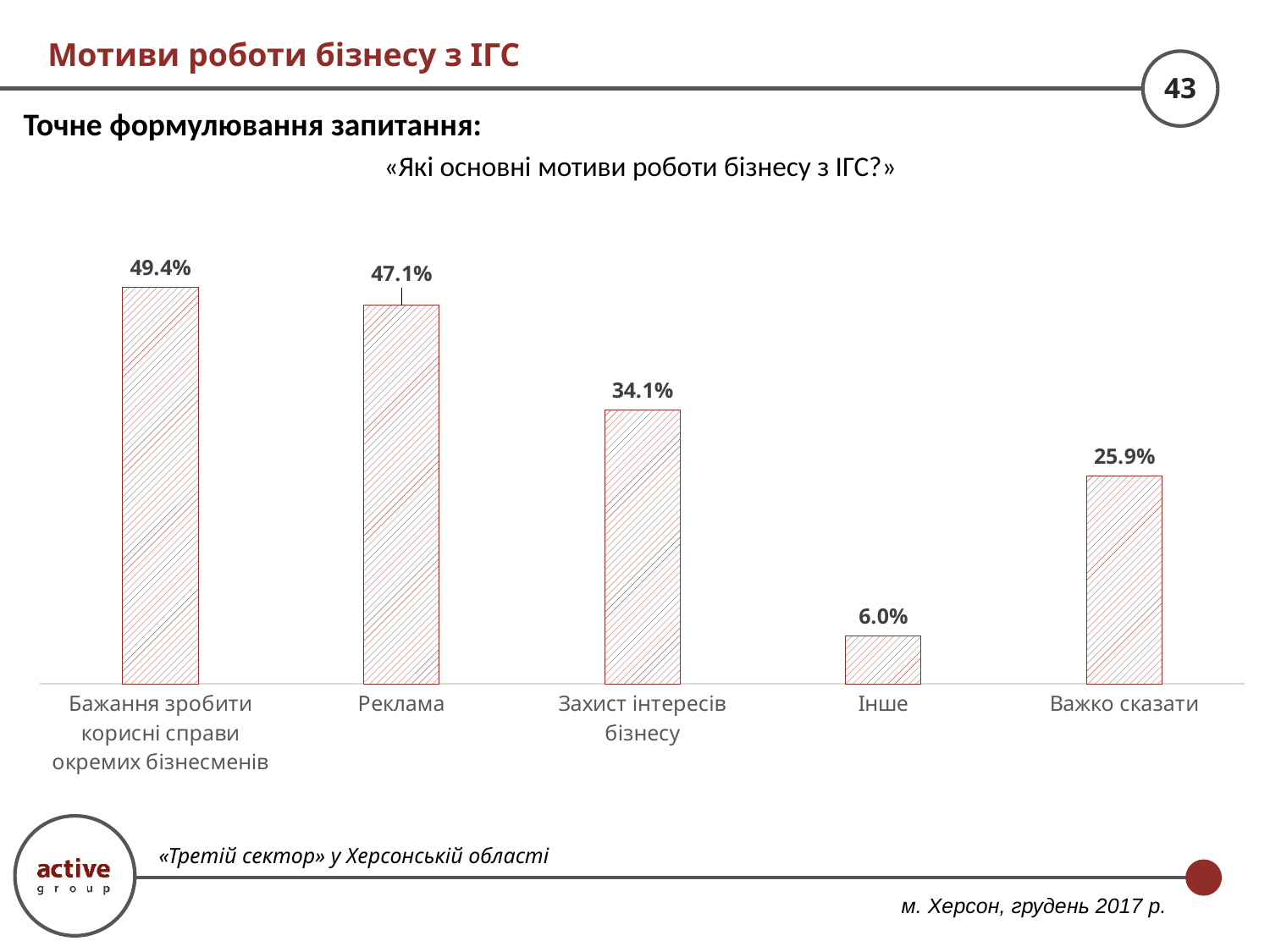
What is the difference between the values for «Важко сказати» and «Інше»? 19.9% What is the exact survey question quoted on the slide? «Які основні мотиви роботи бізнесу з ІГС?» What is the value for «Важко сказати»? 25.9% What is the value for «Реклама»? 47.1% What is the difference between the values for «Реклама» and «Захист інтересів бізнесу»? 13.0% Which category has the lowest value? Інше Which category has the highest value? Бажання зробити корисні справи окремих бізнесменів What kind of chart is shown on the slide? bar chart How many categories are shown in the chart? 5 What is the value for «Захист інтересів бізнесу»? 34.1% Which is larger: the value for «Захист інтересів бізнесу» or the value for «Важко сказати»? Захист інтересів бізнесу What is the value for «Інше»? 6.0%